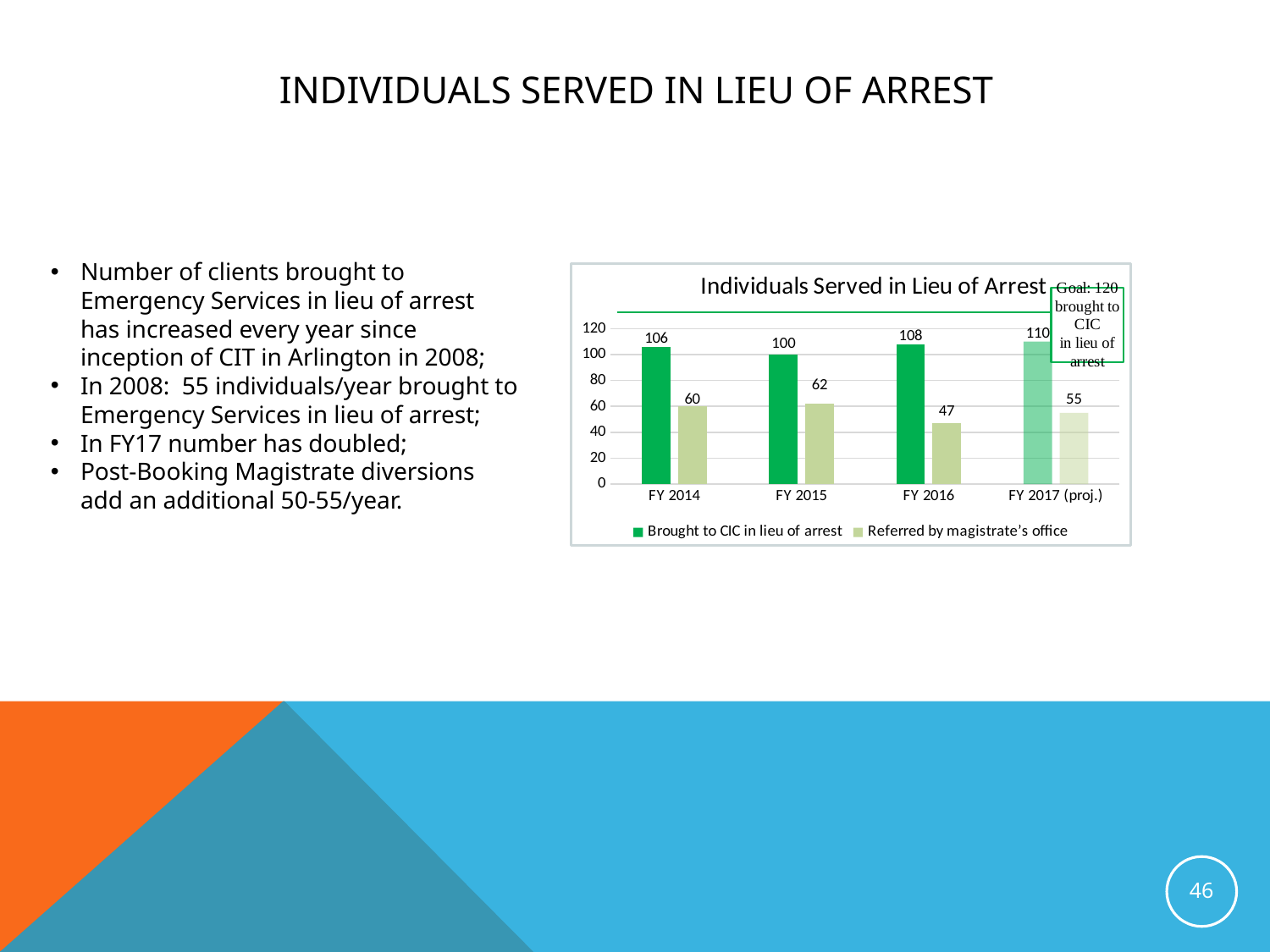
Which fiscal year has the highest value for 'Brought to CIC in lieu of arrest'? FY 2017 (proj.) What goal value is marked by the horizontal line on the chart? 120 What kind of chart is shown on the slide? bar chart What is the value for 'Brought to CIC in lieu of arrest' in FY 2017 (proj.)? 110 Which fiscal year has the lowest value for 'Referred by magistrate's office'? FY 2016 How many series does the chart legend list? 2 Which is larger: 'Referred by magistrate's office' in FY 2015 or in FY 2017 (proj.)? FY 2015 What is the value for 'Referred by magistrate's office' in FY 2016? 47 What is the value for 'Brought to CIC in lieu of arrest' in FY 2014? 106 How many fiscal years are shown on the x axis of the chart? 4 What is the difference between 'Brought to CIC in lieu of arrest' and 'Referred by magistrate's office' in FY 2015? 38 Is the value for 'Brought to CIC in lieu of arrest' in FY 2016 greater or less than 120? less